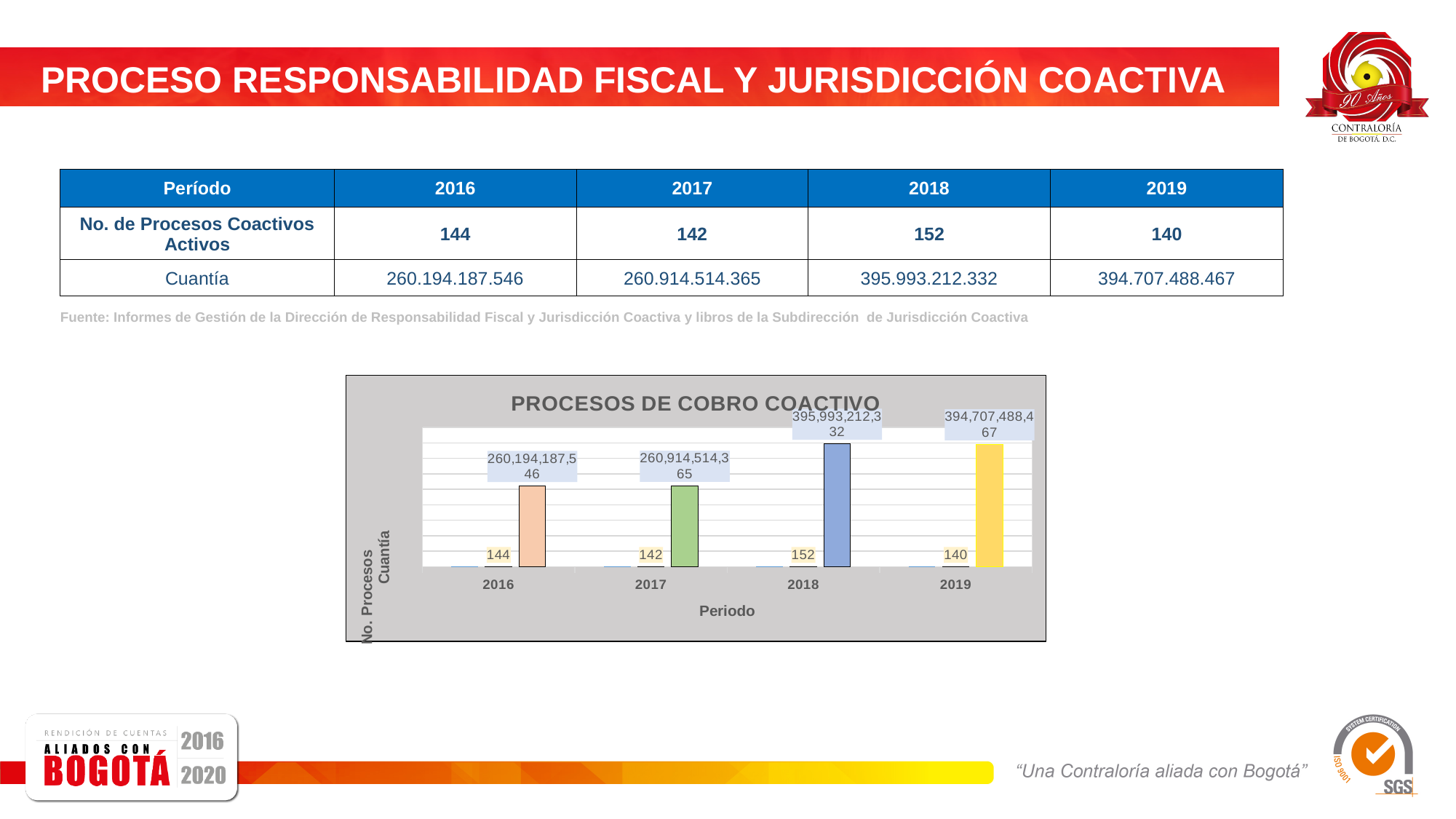
What is the label of the x axis of the chart? Periodo What is the Cuantía value for 2016 in the chart? 260,194,187,546 How many periods are shown on the x axis of the chart? 4 Which period has the lowest number of processes (No. Procesos) in the chart? 2019 What is the Cuantía value for 2018 in the chart? 395,993,212,332 What is the number of processes (No. Procesos) shown for 2019 in the chart? 140 What is the title of the chart? PROCESOS DE COBRO COACTIVO What type of chart is shown on the slide? bar chart What is the difference between the number of processes in 2018 and in 2016? 8 Is the Cuantía for 2019 larger or smaller than the Cuantía for 2017? larger What is the number of processes (No. Procesos) shown for 2017 in the chart? 142 Which period has the highest Cuantía in the chart? 2018